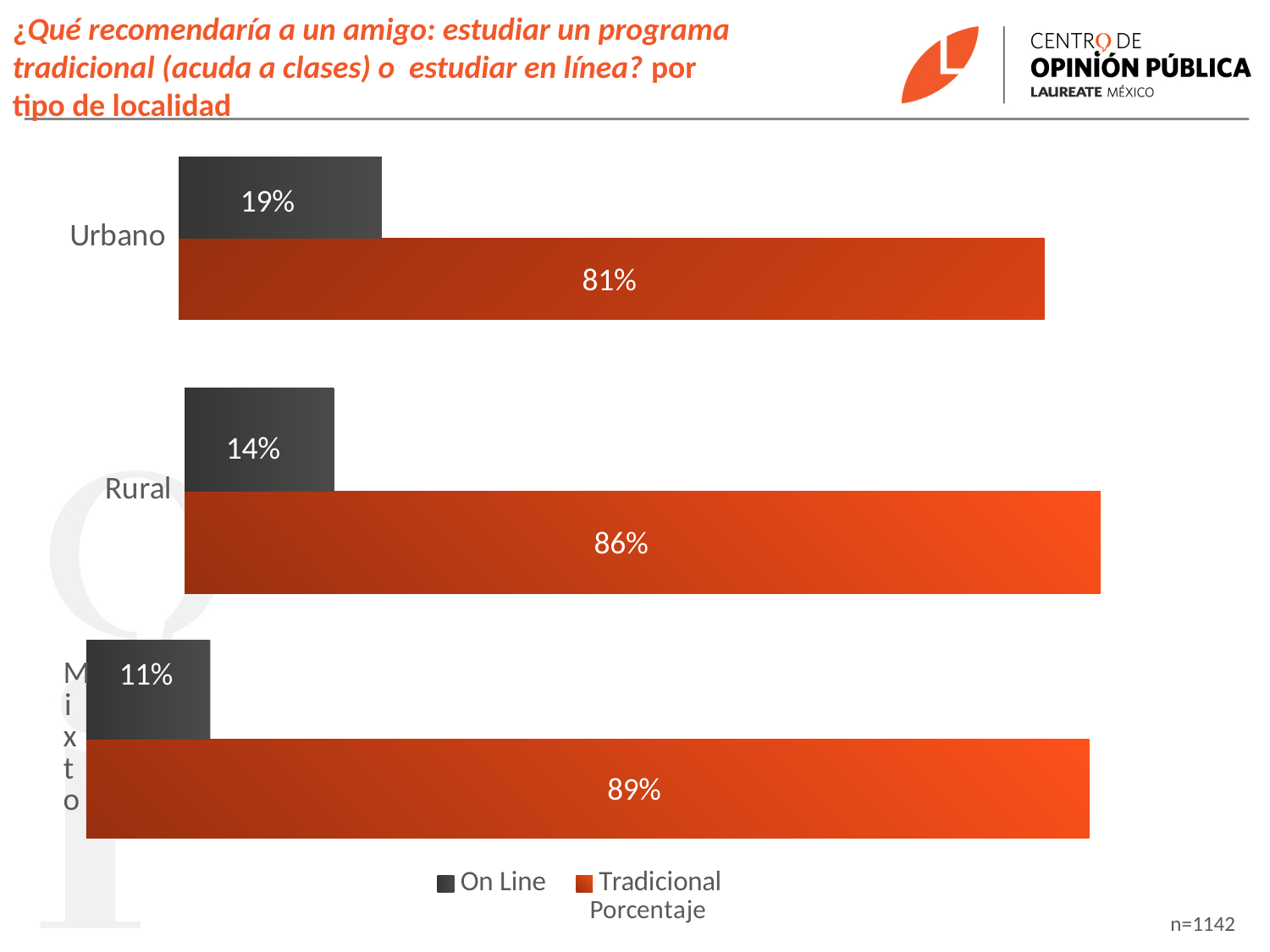
What is the On Line value for Rural? 14% What percentage of Urbano respondents recommend On Line? 19% How many locality types are shown in the chart? 3 What is the difference between the Tradicional and On Line percentages for Urbano? 62% What is the Tradicional value for Mixto? 89% What percentage of Rural respondents recommend Tradicional? 86% Which is larger, the On Line value for Urbano or the On Line value for Rural? Urbano Which locality type has the lowest On Line percentage? Mixto Which series is shown in orange in the legend? Tradicional How many series does the legend list? 2 Which locality type has the highest Tradicional percentage? Mixto What kind of chart is shown on the slide? Bar chart